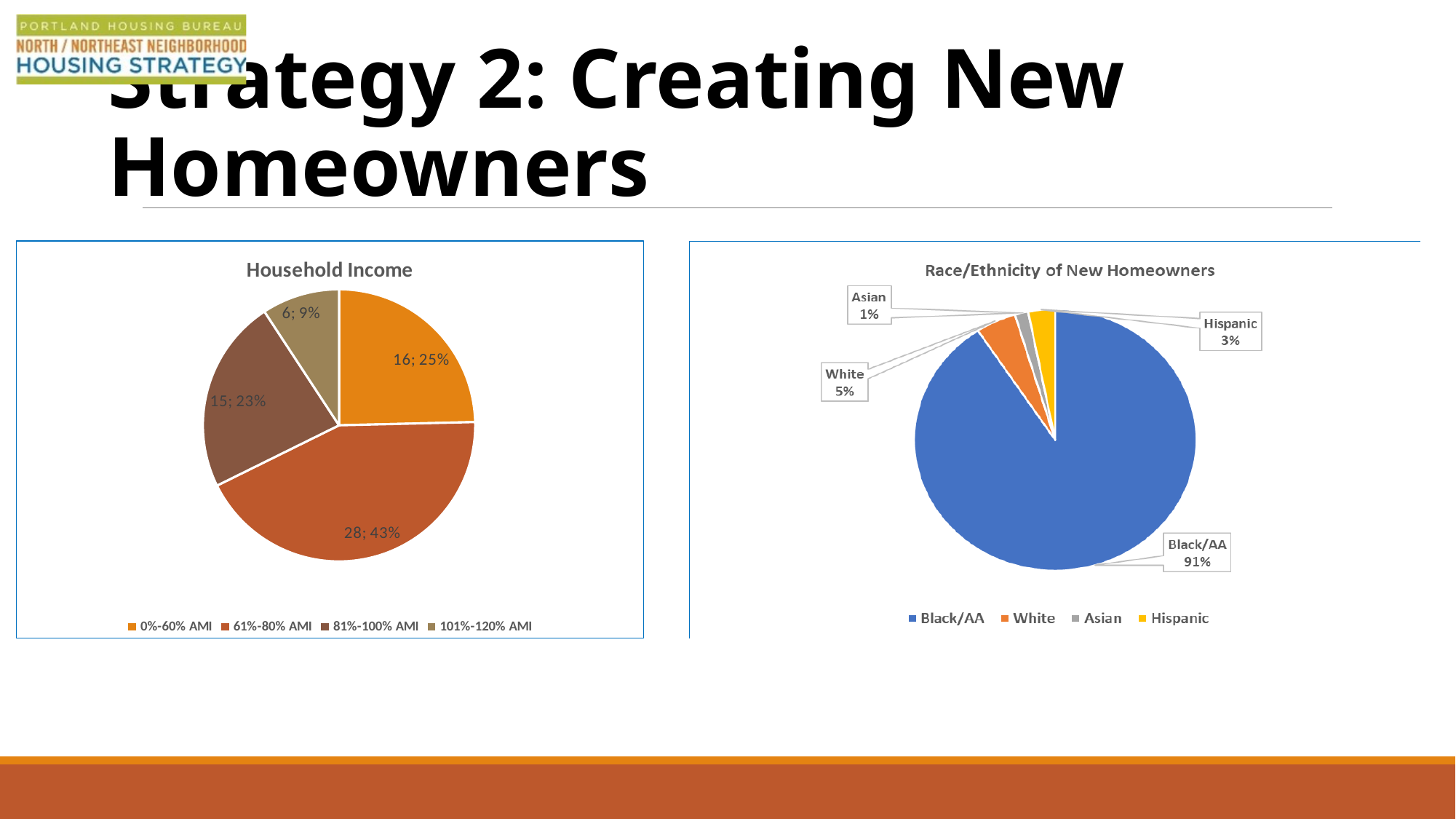
In the Household Income chart, how many households are in the 61%-80% AMI category? 28 What kind of chart is the Race/Ethnicity of New Homeowners chart? Pie chart In the Household Income chart, how many categories does the legend list? 4 In the Household Income chart, which category has the largest slice? 61%-80% AMI In the Household Income chart, which category has the smallest slice? 101%-120% AMI In the Race/Ethnicity of New Homeowners chart, what percentage is Black/AA? 91% In the Household Income chart, what share of the pie is the 0%-60% AMI slice? 25% In the Race/Ethnicity of New Homeowners chart, what colour is the Black/AA slice? Blue In the Race/Ethnicity of New Homeowners chart, which group has the smallest share? Asian In the Household Income chart, what is the difference in count between the 61%-80% AMI and 81%-100% AMI categories? 13 In the Race/Ethnicity of New Homeowners chart, which is larger, White or Hispanic? White In the Household Income chart, what is the total number of households across all four slices? 65